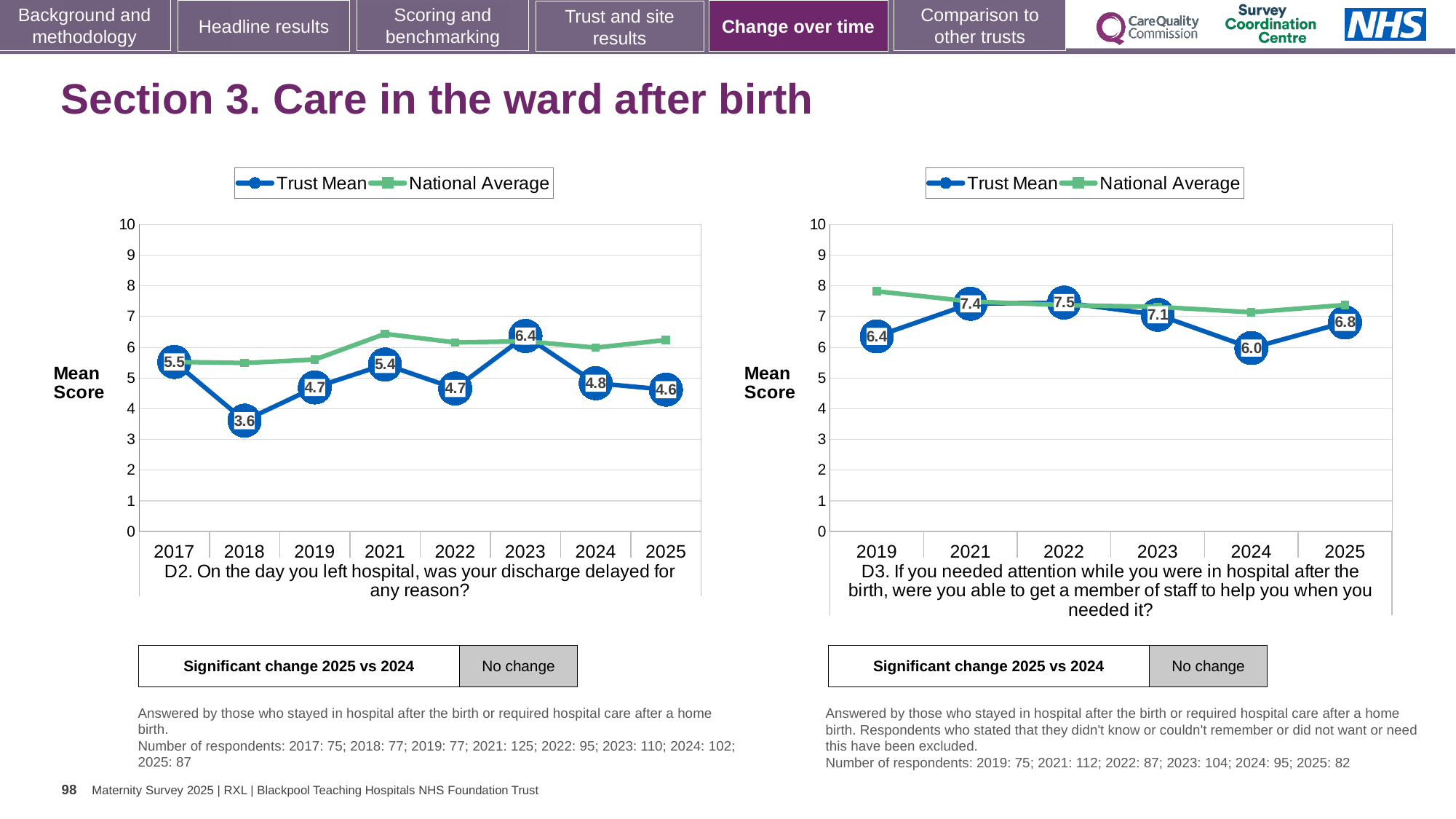
In the right chart (D3, getting a member of staff to help), how many series does the legend list? 2 In the left chart (D2, discharge delayed), which year has the highest Trust Mean? 2023 In the left chart (D2, discharge delayed), what is the Trust Mean for 2023? 6.4 In the right chart (D3, getting a member of staff to help), which year has the highest Trust Mean? 2022 In the right chart (D3, getting a member of staff to help), is the Trust Mean for 2025 larger or smaller than the Trust Mean for 2024? larger In the left chart (D2, discharge delayed), what is the Trust Mean for 2018? 3.6 In the left chart (D2, discharge delayed), is the National Average for 2023 greater or less than 6? greater In the left chart (D2, discharge delayed), how many years are shown on the x axis? 8 In the right chart (D3, getting a member of staff to help), what is the Trust Mean for 2024? 6.0 In the left chart (D2, discharge delayed), which year has the lowest Trust Mean? 2018 What type of chart is the right chart (D3, getting a member of staff to help)? Line chart In the left chart (D2, discharge delayed), what is the difference between the Trust Mean in 2023 and in 2024? 1.6